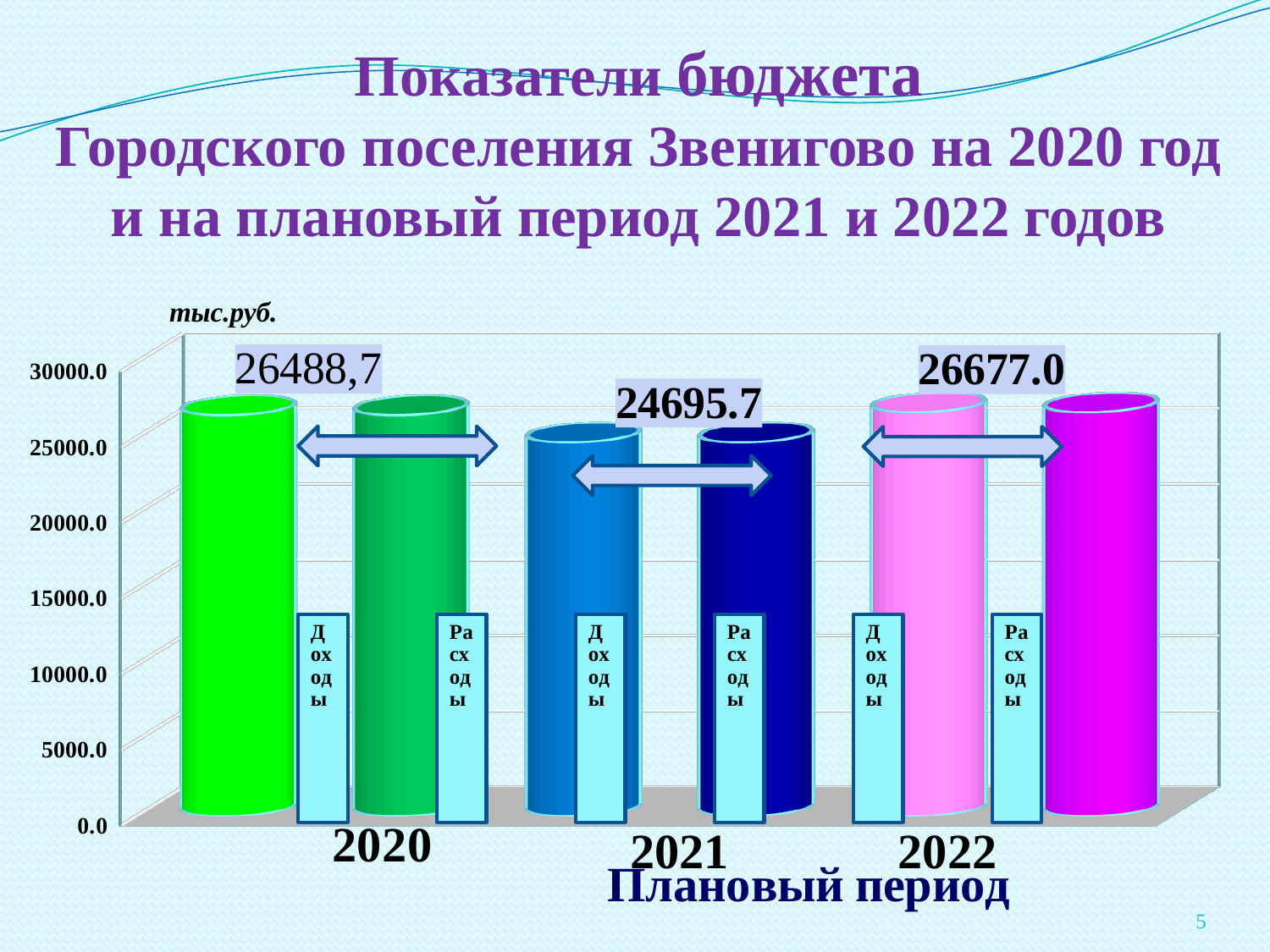
What value is labelled for the 2021 bars on the chart? 24695.7 What value is labelled for the 2020 bars on the chart? 26488,7 What kind of chart is shown on the slide? bar chart What is the difference between the labelled values for 2020 and 2021? 1793.0 Which is larger, the labelled value for 2020 or for 2021? 2020 How many year groups are shown on the x axis of the chart? 3 What is the difference between the labelled values for 2022 and 2021? 1981.3 What value is labelled for the 2022 bars on the chart? 26677.0 Which year has the highest labelled value on the chart? 2022 Which year has the lowest labelled value on the chart? 2021 Is the value for Доходы in 2021 greater or less than 20000.0? greater What unit is indicated above the vertical axis of the chart? тыс.руб.